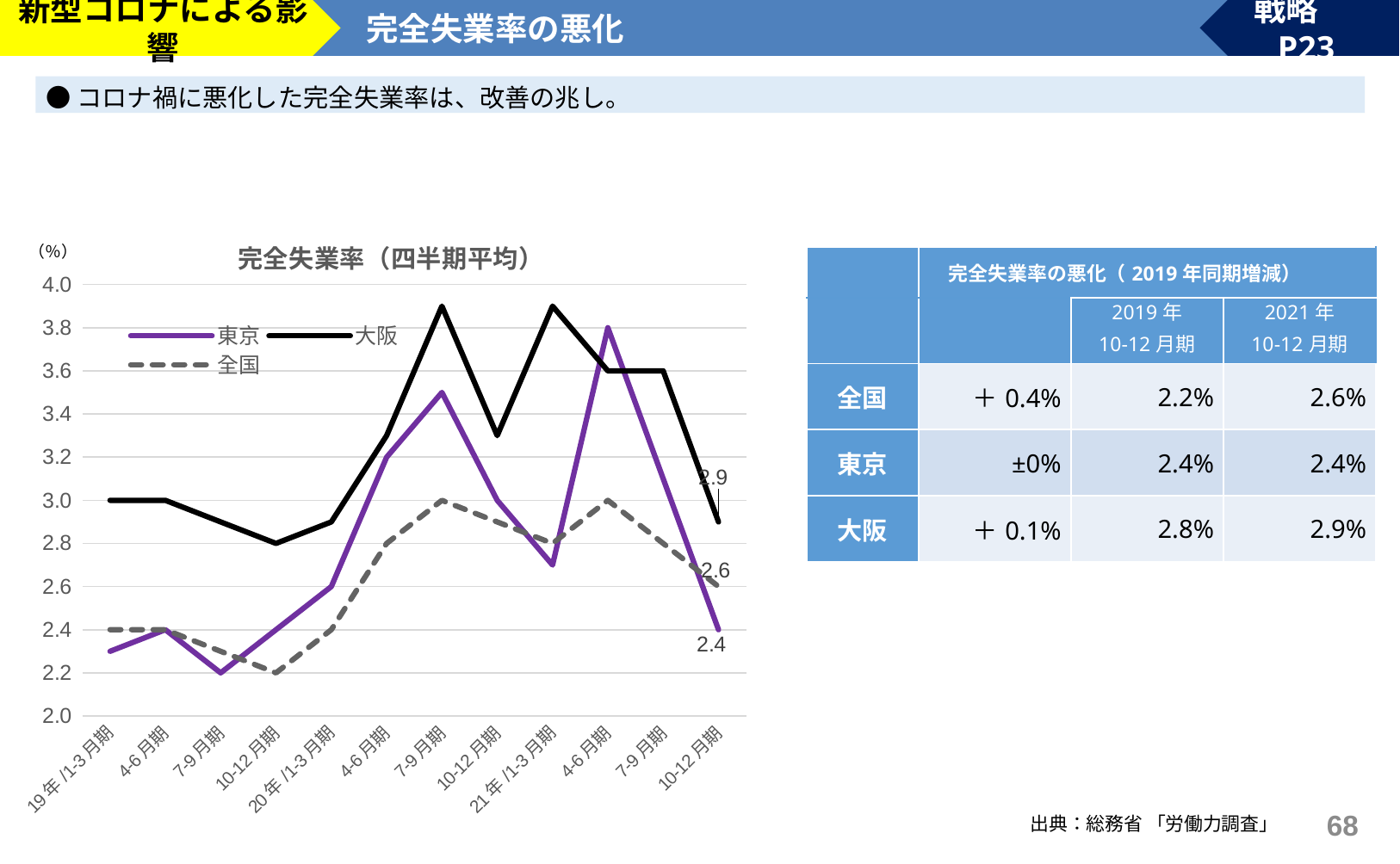
How many series does the legend of the 完全失業率（四半期平均） chart list? 3 In the 完全失業率（四半期平均） chart, what is the value for 東京 at the final quarter (21年 10-12月期)? 2.4 In the 完全失業率（四半期平均） chart, which series is drawn with a dashed line? 全国 In the 完全失業率（四半期平均） chart, what is the value for 全国 at the final quarter (21年 10-12月期)? 2.6 In the 完全失業率（四半期平均） chart, what is the difference between 大阪 and 東京 at the final quarter (21年 10-12月期)? 0.5 In the 完全失業率（四半期平均） chart, which series has the highest value at the final quarter (21年 10-12月期)? 大阪 How many quarters are plotted along the x axis of the 完全失業率（四半期平均） chart? 12 In the 完全失業率（四半期平均） chart, what is the value for 大阪 at the final quarter (21年 10-12月期)? 2.9 In the 完全失業率（四半期平均） chart, which is larger at the final quarter (21年 10-12月期): 全国 or 東京? 全国 What kind of chart is shown under the title 完全失業率（四半期平均）? line chart In the 完全失業率（四半期平均） chart, is the value for 大阪 at 20年 7-9月期 greater or less than 3.6? greater In the 完全失業率（四半期平均） chart, does the 東京 line rise or fall from 21年 4-6月期 to 21年 10-12月期? fall